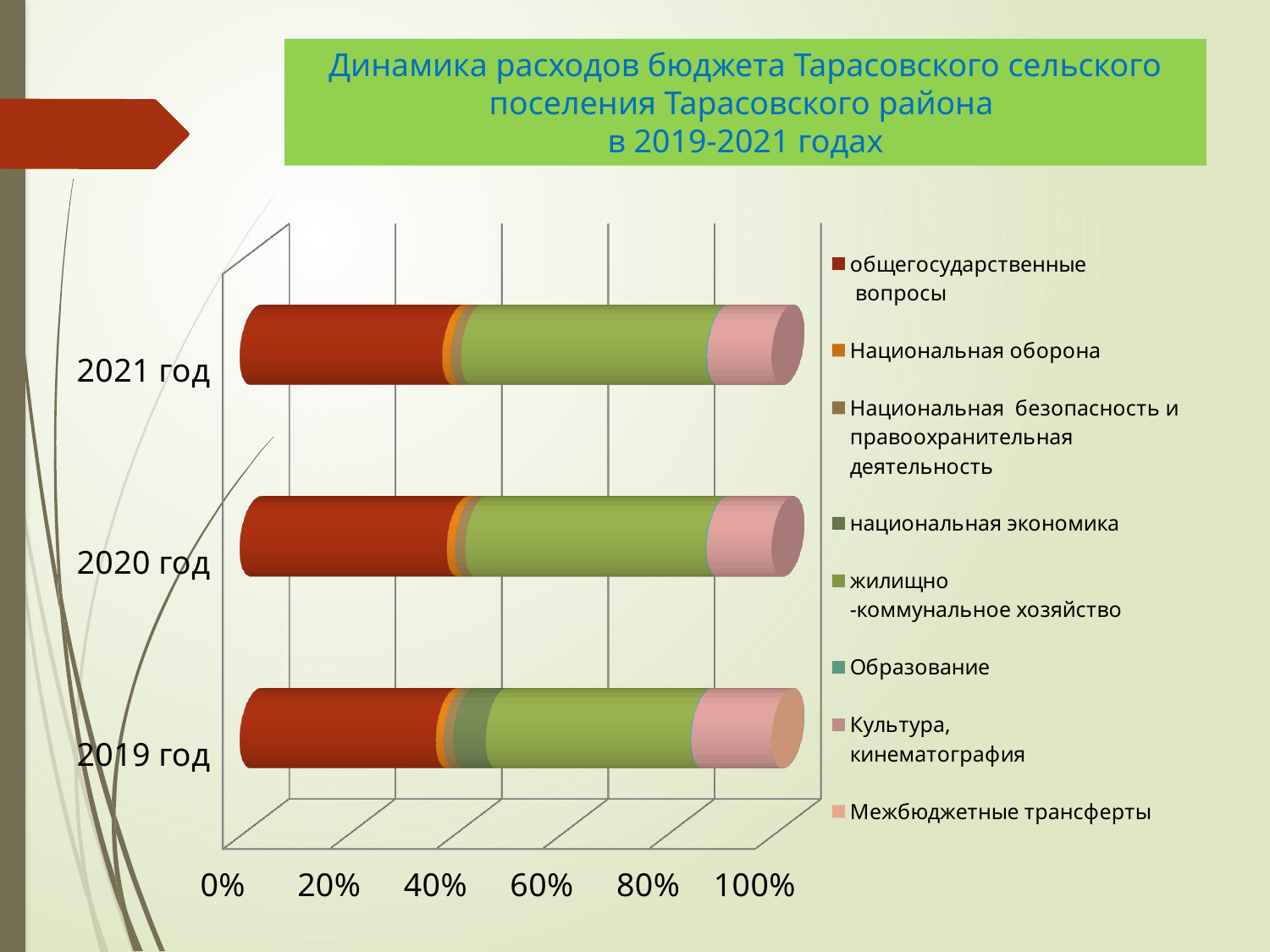
Is the share of общегосударственные вопросы in 2021 год greater or less than 20%? greater Is the share of Культура, кинематография in 2021 год greater or less than 40%? less Which legend entry is shown in dark red? общегосударственные вопросы What is the highest value shown on the horizontal axis? 100% What is the title of the chart on the slide? Динамика расходов бюджета Тарасовского сельского поселения Тарасовского района в 2019-2021 годах What kind of chart is shown on the slide? stacked bar chart Is the share of жилищно-коммунальное хозяйство in 2020 год greater or less than 20%? greater How many years (categories) are plotted on the chart? 3 How many series does the chart legend list? 8